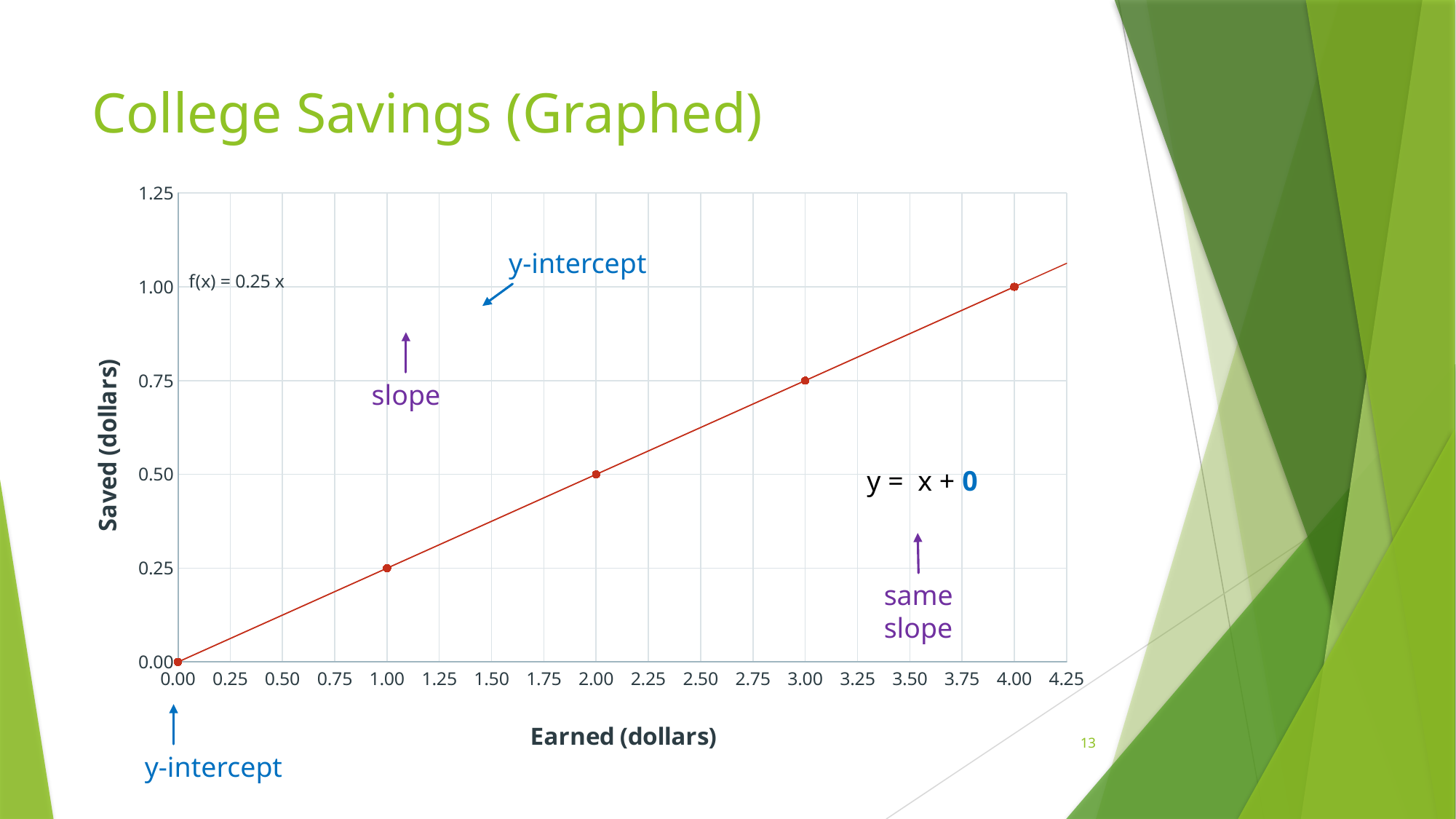
At which Earned (dollars) value is Saved (dollars) the lowest? 0.00 What is the value of Saved (dollars) when Earned (dollars) is 2.00? 0.50 What is the label of the x axis? Earned (dollars) How many data points are plotted on the chart? 5 What is the value of Saved (dollars) when Earned (dollars) is 1.00? 0.25 At which Earned (dollars) value is Saved (dollars) the highest? 4.00 Which has a larger Saved (dollars) value: Earned = 3.00 or Earned = 2.00? Earned = 3.00 Do the Saved (dollars) values rise or fall as Earned (dollars) increases? rise What is the difference in Saved (dollars) between Earned = 3.00 and Earned = 1.00? 0.50 What is the value of Saved (dollars) when Earned (dollars) is 4.00? 1.00 What kind of chart is shown on the slide? scatter plot with a trend line What is the trend line equation printed on the chart? f(x) = 0.25 x